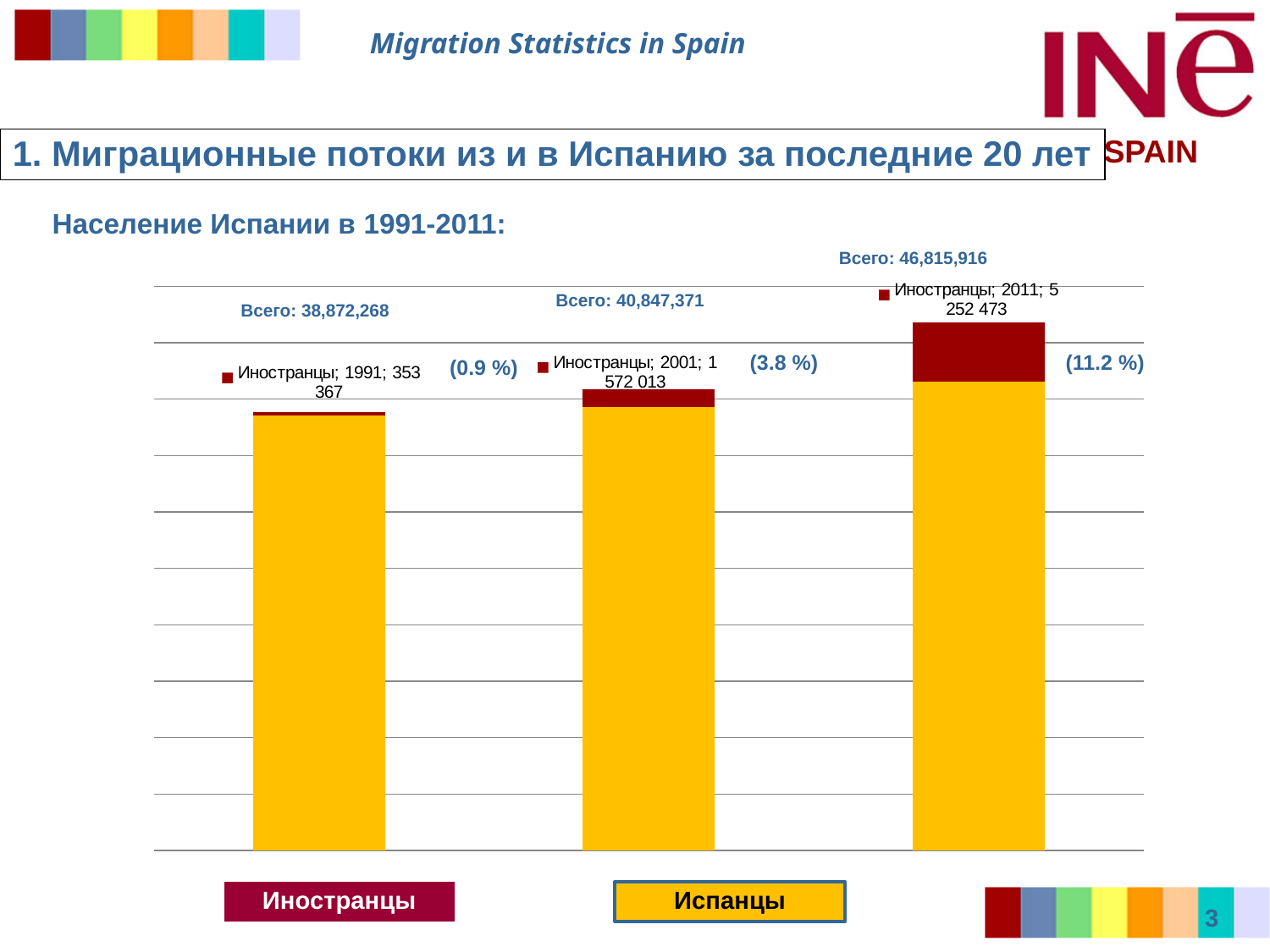
By how much did the number of Иностранцы increase from 2001 to 2011? 3 680 460 What is the total population (Всего) shown for 2011? 46,815,916 Which year has the lowest total population? 1991 Which year has the highest number of Иностранцы? 2011 What is the difference between the total population in 2011 and in 1991? 7,943,648 What percentage share of the population do Иностранцы make up in 2011, as printed on the slide? 11.2 % What is the number of Иностранцы (foreigners) shown for 1991? 353 367 What is the number of Иностранцы shown for 2011? 5 252 473 What is the number of Иностранцы shown for 2001? 1 572 013 What type of chart is shown on the slide? Stacked bar chart What is the total population (Всего) shown for 1991? 38,872,268 How many years (bars) are shown in the chart? 3